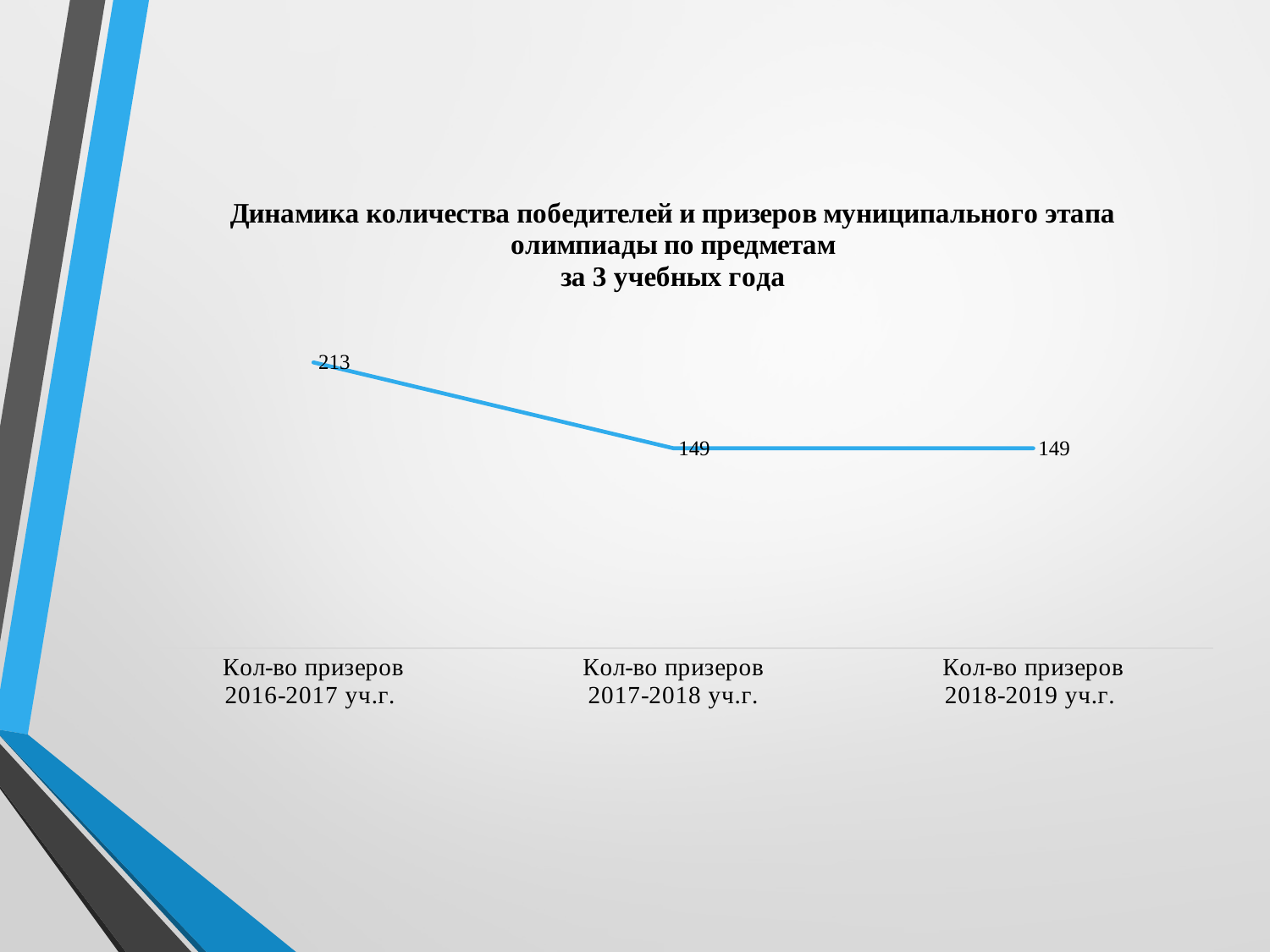
Which is larger: the value for 2016-2017 уч.г. or the value for 2018-2019 уч.г.? 2016-2017 уч.г. Does the value change between 2017-2018 уч.г. and 2018-2019 уч.г.? No, it stays at 149 What is the title of the chart? Динамика количества победителей и призеров муниципального этапа олимпиады по предметам за 3 учебных года Do the values rise or fall from 2016-2017 уч.г. to 2017-2018 уч.г.? fall What colour is the line on the chart? blue What is the difference between the values for 2016-2017 уч.г. and 2017-2018 уч.г.? 64 Which category has the highest value? Кол-во призеров 2016-2017 уч.г. What kind of chart is shown on the slide? line chart What is the value for Кол-во призеров 2017-2018 уч.г.? 149 What is the value for Кол-во призеров 2016-2017 уч.г.? 213 How many data points are plotted on the chart? 3 What is the value for Кол-во призеров 2018-2019 уч.г.? 149